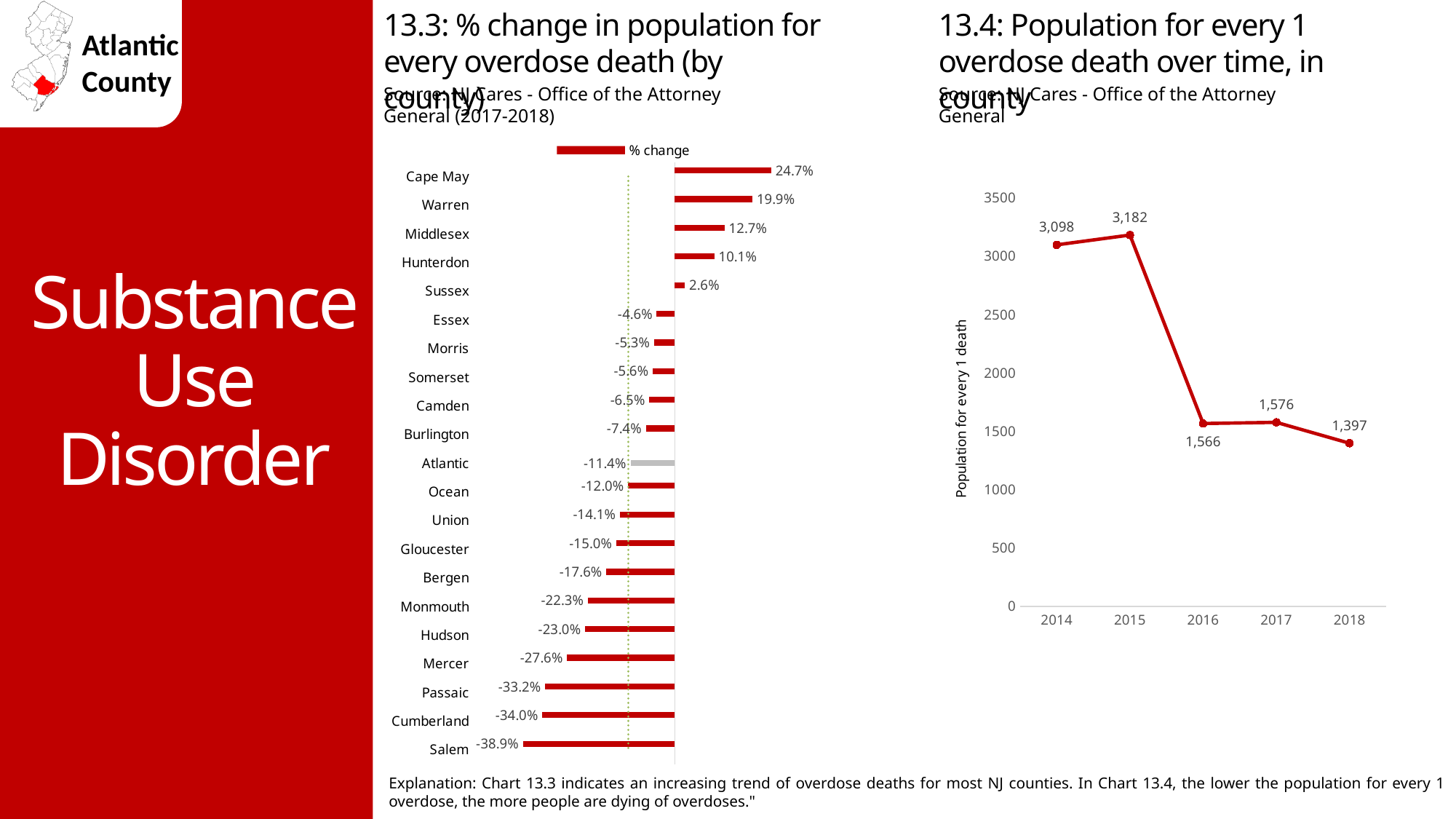
In chart 13.3, how many counties are shown? 21 In chart 13.3, what is the % change for Warren? 19.9% In chart 13.4, what is the difference between the 2014 and 2016 values? 1,532 In chart 13.3, which county has the highest % change? Cape May In chart 13.4, what is the population for every 1 overdose death in 2015? 3,182 In chart 13.3, what is the % change in population for every overdose death for Atlantic? -11.4% In chart 13.3, which county has the lowest % change? Salem In chart 13.4, what is the population for every 1 overdose death in 2018? 1,397 In chart 13.4, does the population for every 1 overdose death generally rise or fall from 2014 to 2018? Fall In chart 13.3, which has a larger % change, Hunterdon or Sussex? Hunterdon In chart 13.4, which year has the highest population for every 1 overdose death? 2015 In chart 13.3, what kind of chart is used? Bar chart